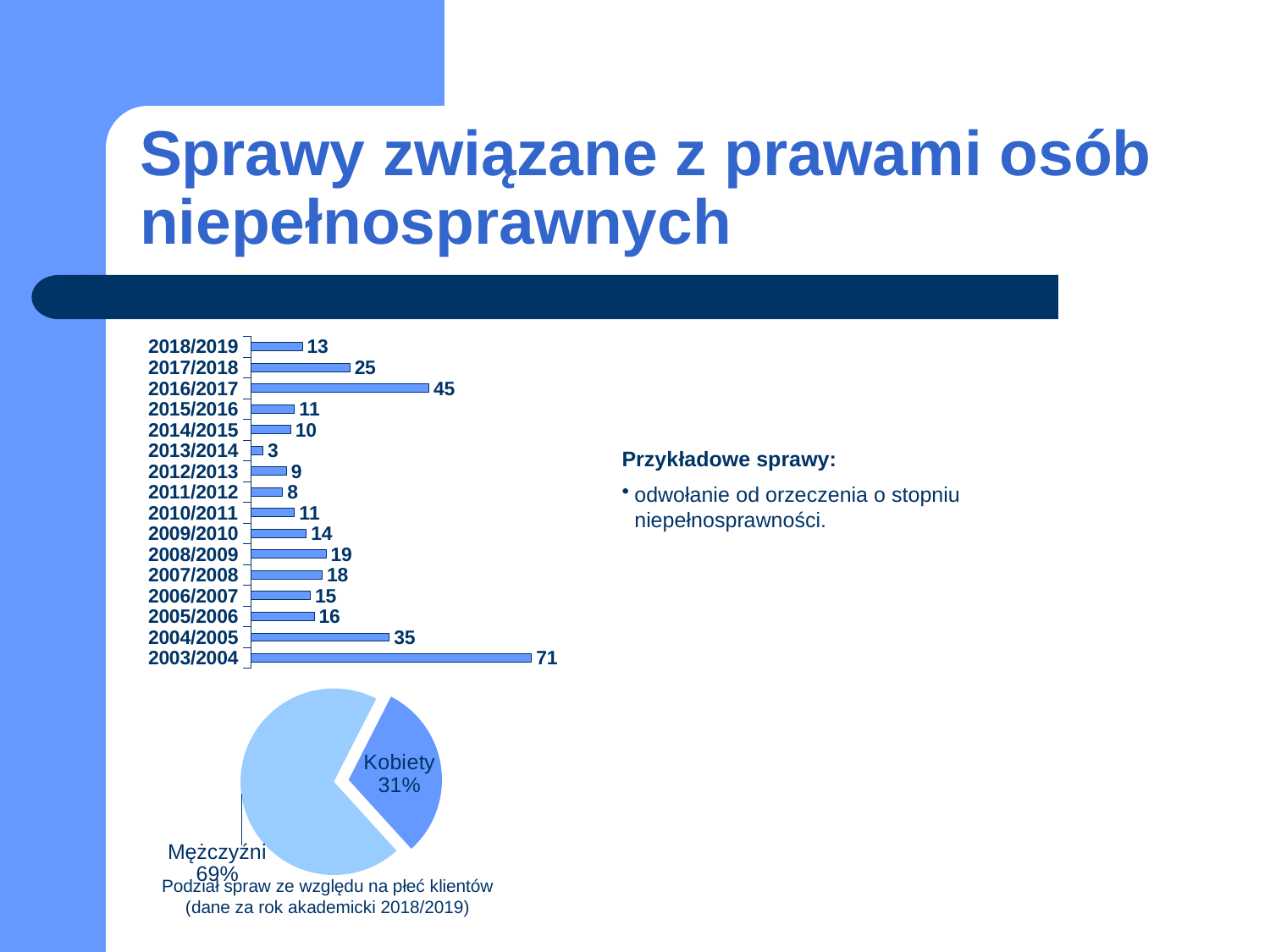
In the pie chart at the bottom left of the slide, what share is labelled Kobiety? 31% In the bar chart at the top left of the slide, what is the value for 2013/2014? 3 How many academic years are shown in the bar chart at the top left of the slide? 16 In the bar chart at the top left of the slide, which academic year has the highest value? 2003/2004 In the bar chart at the top left of the slide, what is the difference between the values for 2003/2004 and 2004/2005? 36 What kind of chart is the chart at the top left of the slide? Bar chart In the bar chart at the top left of the slide, which is larger: the value for 2017/2018 or the value for 2018/2019? 2017/2018 In the bar chart at the top left of the slide, what is the value for 2003/2004? 71 What is the title of the pie chart at the bottom left of the slide? Podział spraw ze względu na płeć klientów (dane za rok akademicki 2018/2019) In the bar chart at the top left of the slide, which academic year has the lowest value? 2013/2014 In the pie chart at the bottom left of the slide, what share is labelled Mężczyźni? 69% In the bar chart at the top left of the slide, what is the value for 2016/2017? 45